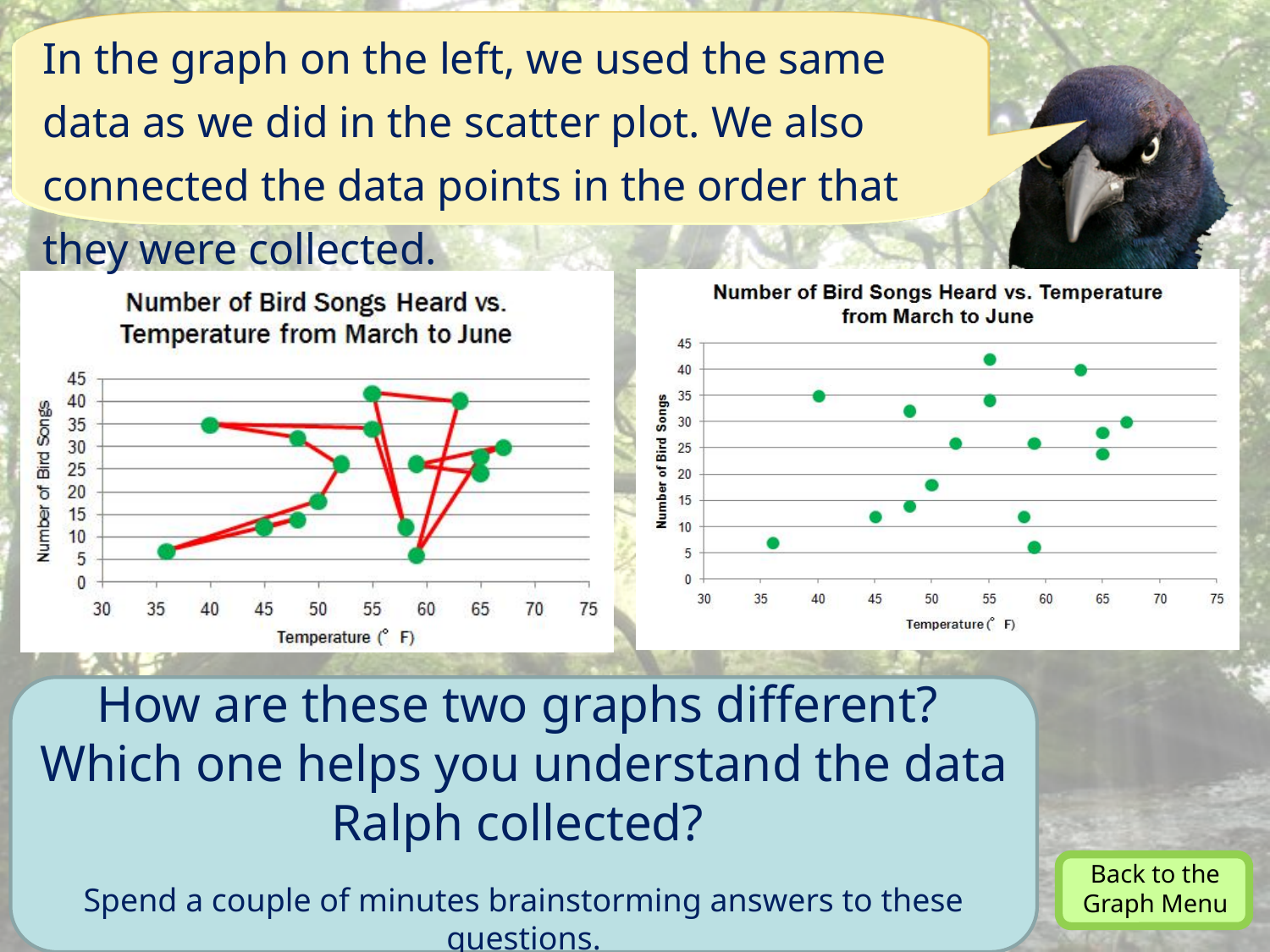
In the graph on the right, which is larger: the number of bird songs heard at 40°F or at 45°F? 40°F How many data points are plotted in the graph on the right? 16 In the graph on the right, at which temperature was the highest number of bird songs heard? 55 What is the title of the graph on the right? Number of Bird Songs Heard vs. Temperature from March to June In the graph on the right, is the number of bird songs heard at 63°F greater or less than 35? greater In the graph on the left, is the number of bird songs heard at 40°F greater or less than 30? greater In the graph on the right, is the number of bird songs heard at the lowest temperature (about 36°F) greater or less than 10? less In the graph on the left, what is the label of the x axis? Temperature (°F) In the graph on the left, how are the data points displayed differently from the graph on the right? They are connected by lines What kind of chart is the graph on the right of the slide? scatter plot